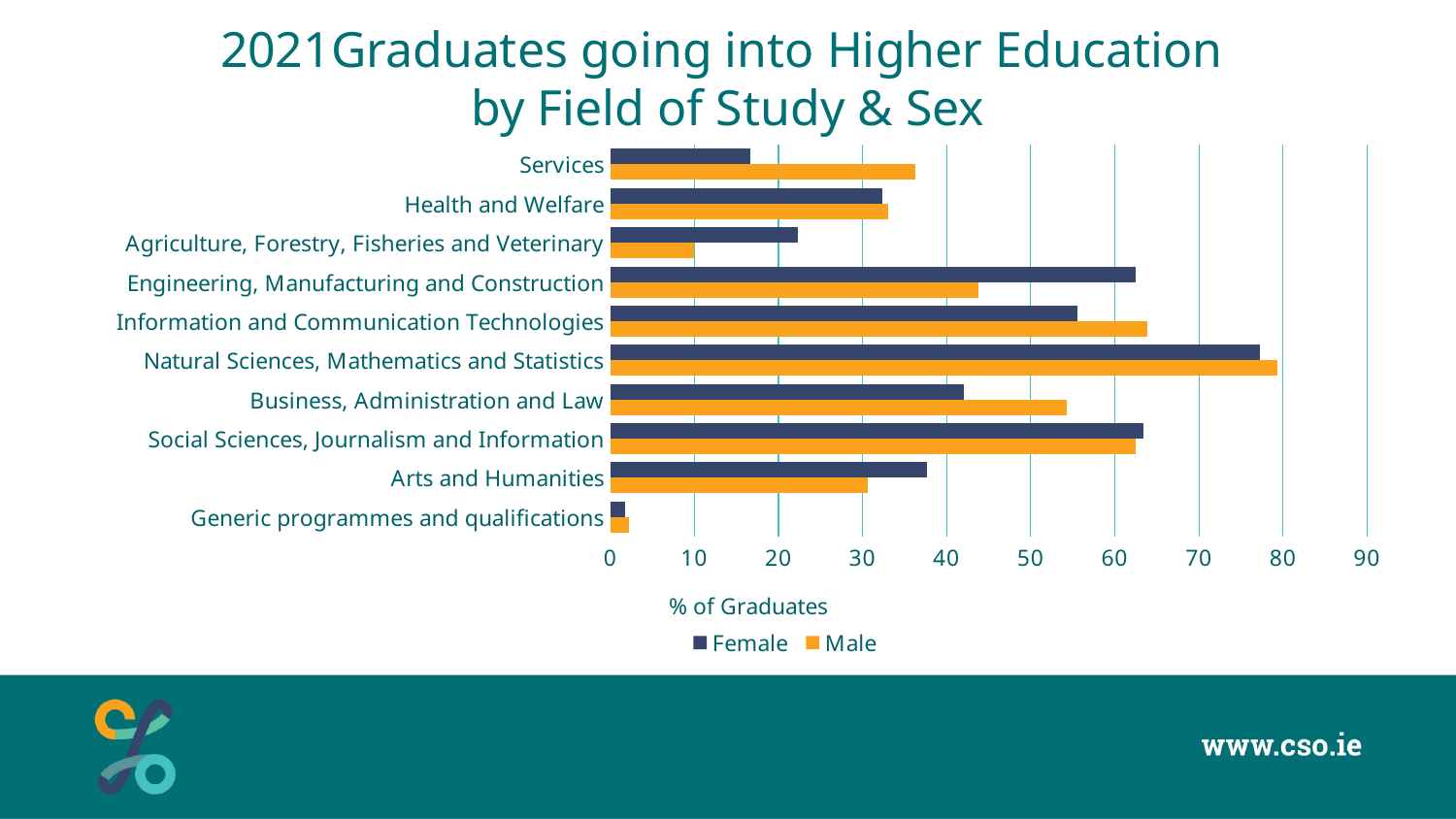
What kind of chart is shown on the slide? Bar chart Is the Female value for Arts and Humanities greater or less than 40? less Is the Female value for Services greater or less than 20? less Is the Female value for Engineering, Manufacturing and Construction greater or less than 60? greater For Engineering, Manufacturing and Construction, which is larger, the Female value or the Male value? Female Which field of study has the highest Female value? Natural Sciences, Mathematics and Statistics How many fields of study are shown on the chart? 10 How many series does the legend list? 2 What is the title of the horizontal axis? % of Graduates For Services, which is larger, the Female value or the Male value? Male Which field of study has the lowest Male value? Generic programmes and qualifications